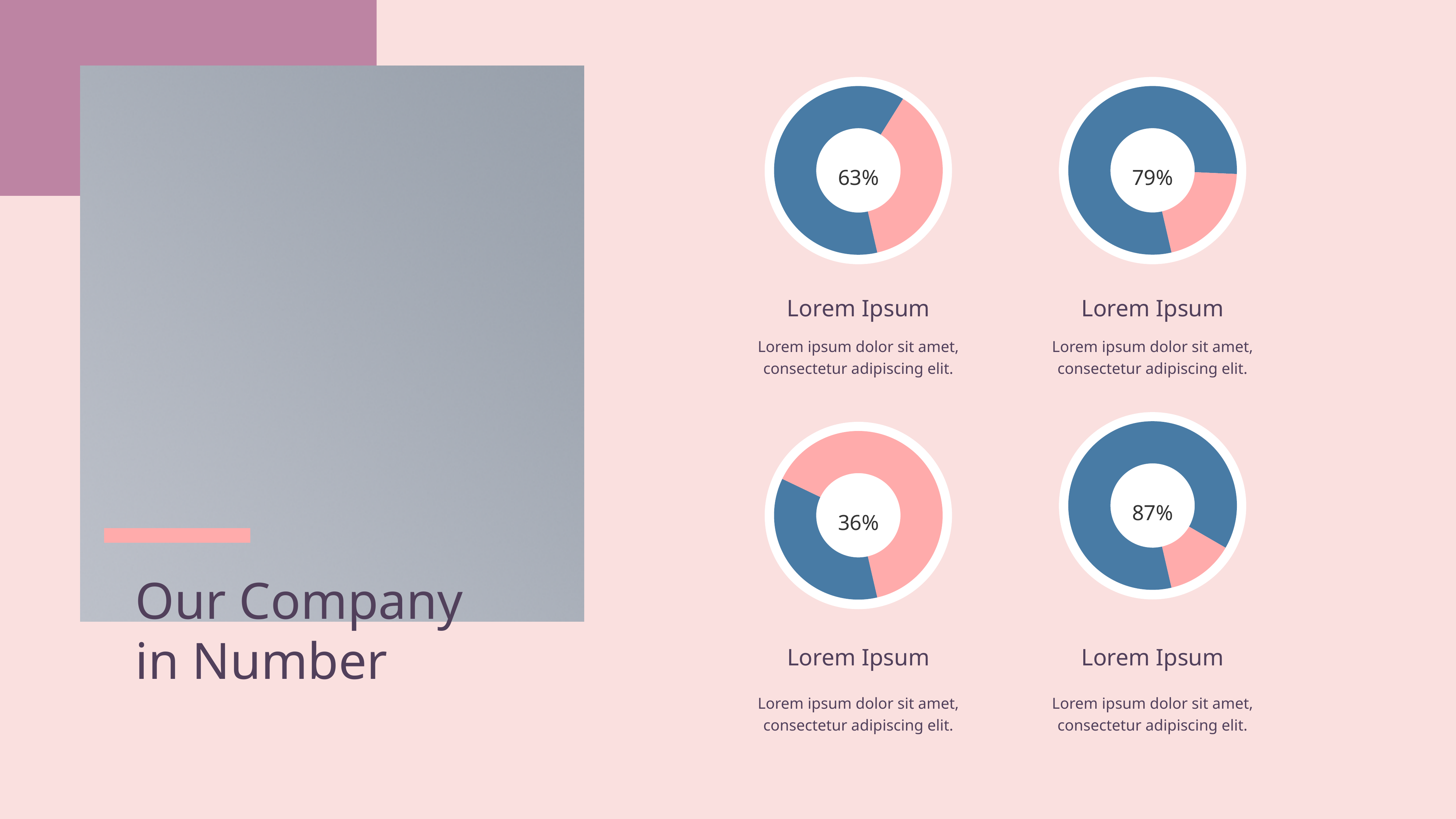
What is the difference between the percentage in the bottom-right donut chart and the percentage in the bottom-left donut chart? 51% What percentage is shown in the centre of the bottom-right donut chart? 87% What percentage is shown in the centre of the top-left donut chart? 63% Which shows a larger percentage, the top-left donut chart or the top-right donut chart? The top-right chart Which of the four donut charts shows the highest percentage? The bottom-right chart (87%) What percentage is shown in the centre of the bottom-left donut chart? 36% What is the difference between the percentage in the top-right donut chart and the percentage in the top-left donut chart? 16% What kind of chart is used for each of the four figures on the right of the slide? Donut chart Which of the four donut charts shows the lowest percentage? The bottom-left chart (36%) What percentage is shown in the centre of the top-right donut chart? 79% How many donut charts are on the slide? 4 What colour is the filled (percentage) portion of the donut charts? Blue